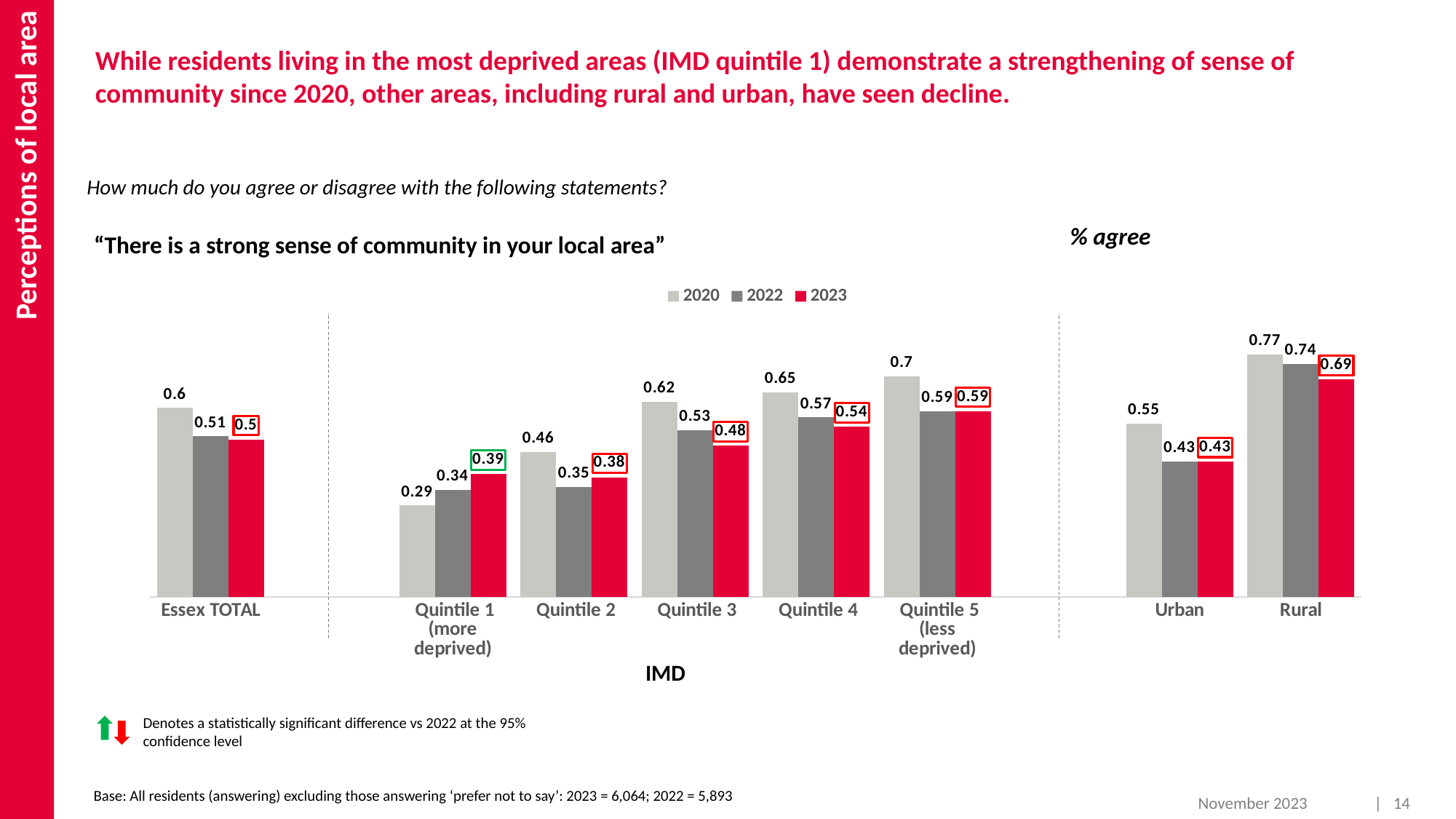
Do the values for Quintile 1 (more deprived) rise or fall from 2020 to 2023? Rise What kind of chart is shown? Bar chart What is the 2023 value for Quintile 1 (more deprived)? 0.39 What is the 2022 value for Essex TOTAL? 0.51 How many series does the legend list? 3 Which is larger: the 2023 value for Urban or the 2023 value for Quintile 2? Urban What is the 2020 value for Rural? 0.77 Which category has the lowest 2020 value? Quintile 1 (more deprived) Which series is shown in red in the legend? 2023 How many categories are shown on the x axis? 8 Which category has the highest 2023 value? Rural What is the difference between the 2020 and 2023 values for Quintile 3? 0.14